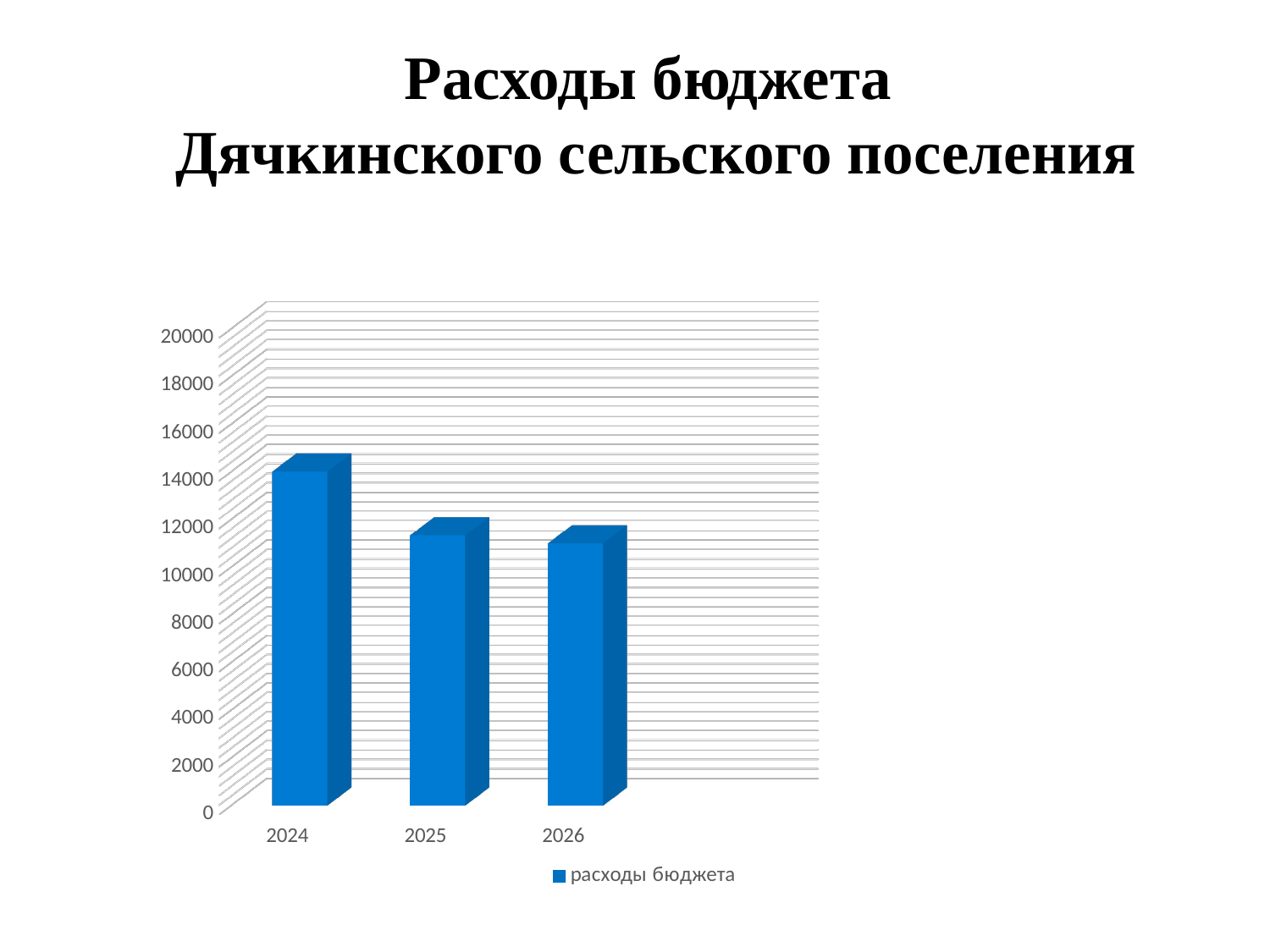
Do the values rise or fall from 2024 to 2026? fall Which is larger, the value for 2024 or the value for 2026? 2024 How many years are shown on the x axis of the chart? 3 Which year has the highest budget expenditure in the chart? 2024 Is the value for 2024 greater or less than 16000? less Is the value for 2025 greater or less than 10000? greater Is the value for 2026 greater or less than 14000? less How many series does the chart legend list? 1 What kind of chart is shown on the slide? bar chart What is the name of the series shown in the chart legend? расходы бюджета Which is larger, the value for 2024 or the value for 2025? 2024